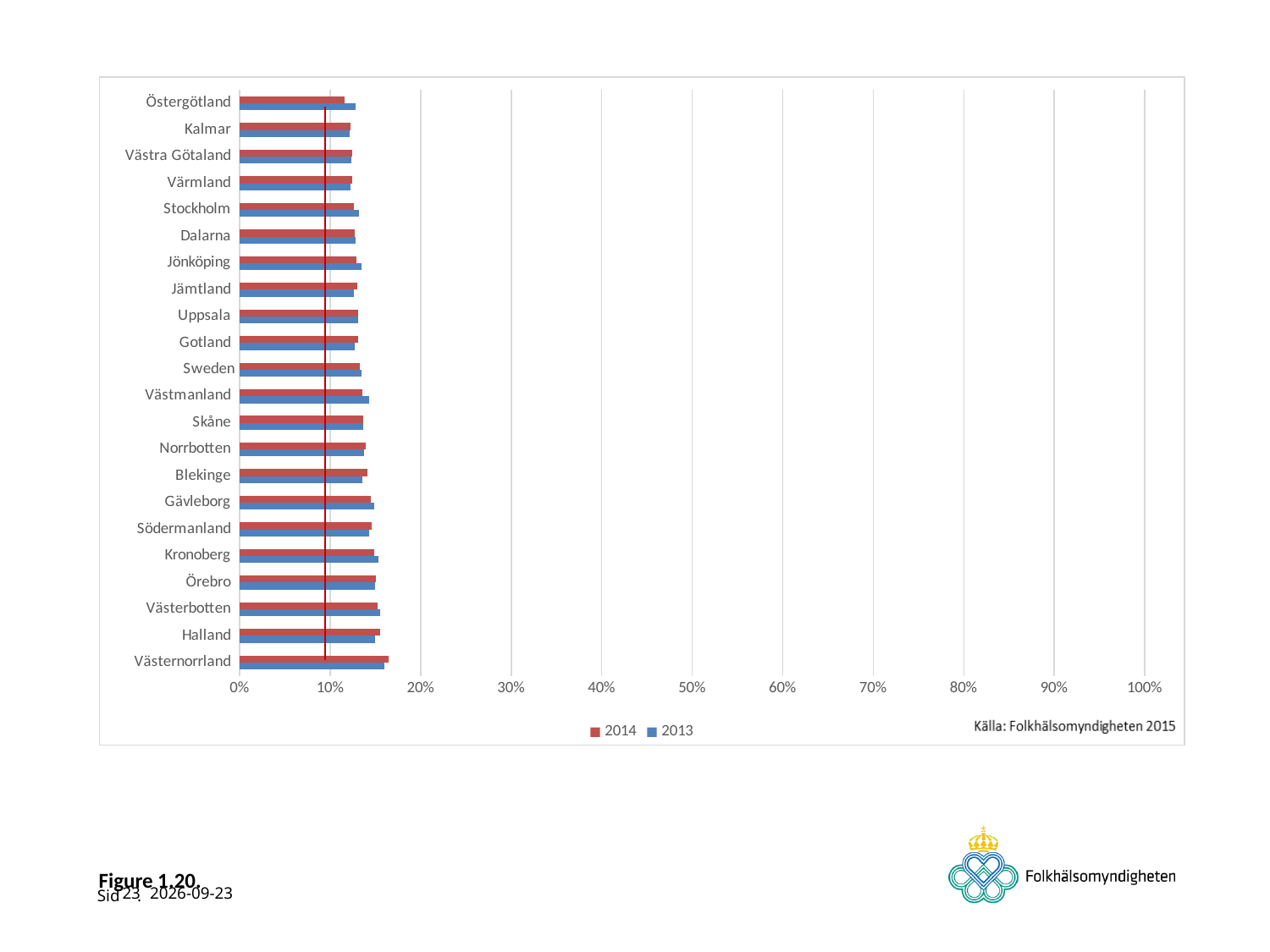
Is the 2014 value for Västernorrland greater or less than 20%? less What is the highest value shown on the horizontal axis? 100% Which has the larger 2014 value, Västernorrland or Östergötland? Västernorrland How many categories (regions, including Sweden) are plotted on the chart? 22 What kind of chart is shown on the slide? bar chart Which category has the highest 2014 value? Västernorrland For Östergötland, which year has the larger value, 2013 or 2014? 2013 Is the 2013 value for Halland greater or less than 10%? greater Is the 2013 value for Sweden greater or less than 20%? less Which years are listed in the legend? 2014 and 2013 How many series does the legend list? 2